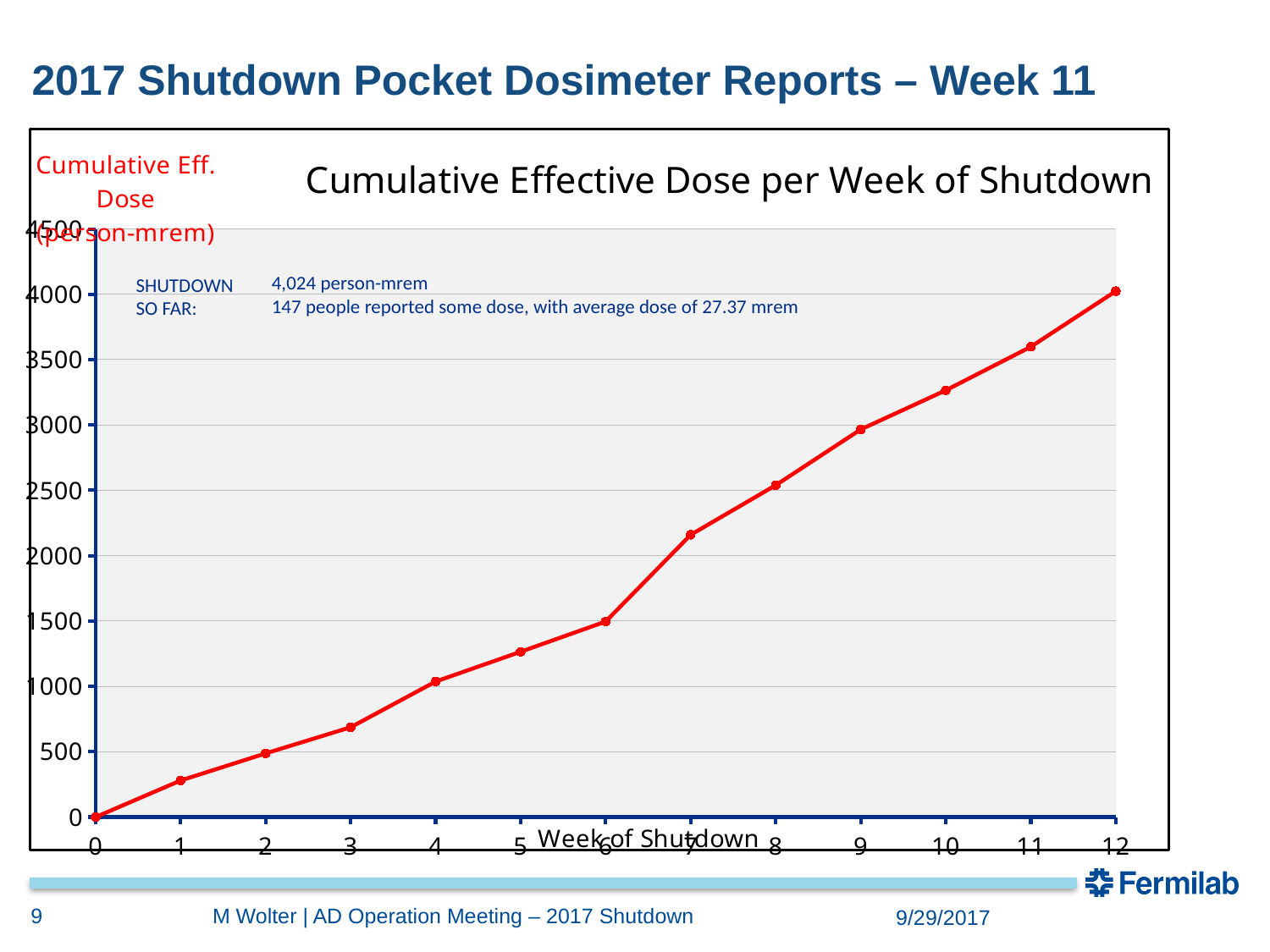
What is the label of the x axis? Week of Shutdown At which week is the cumulative effective dose highest? 12 Is the cumulative effective dose at week 3 greater or less than 1000? less How many data points are plotted on the line? 13 What is the cumulative effective dose at week 0? 0 What is the title of the chart? Cumulative Effective Dose per Week of Shutdown Does the cumulative effective dose rise or fall as the week of shutdown increases? rise Is the cumulative effective dose at week 7 greater or less than 2000? greater What is the cumulative effective dose at week 12 of the shutdown? 4,024 person-mrem At which week is the cumulative effective dose lowest? 0 What kind of chart is shown on the slide? line chart Is the cumulative effective dose at week 10 greater or less than 3000? greater